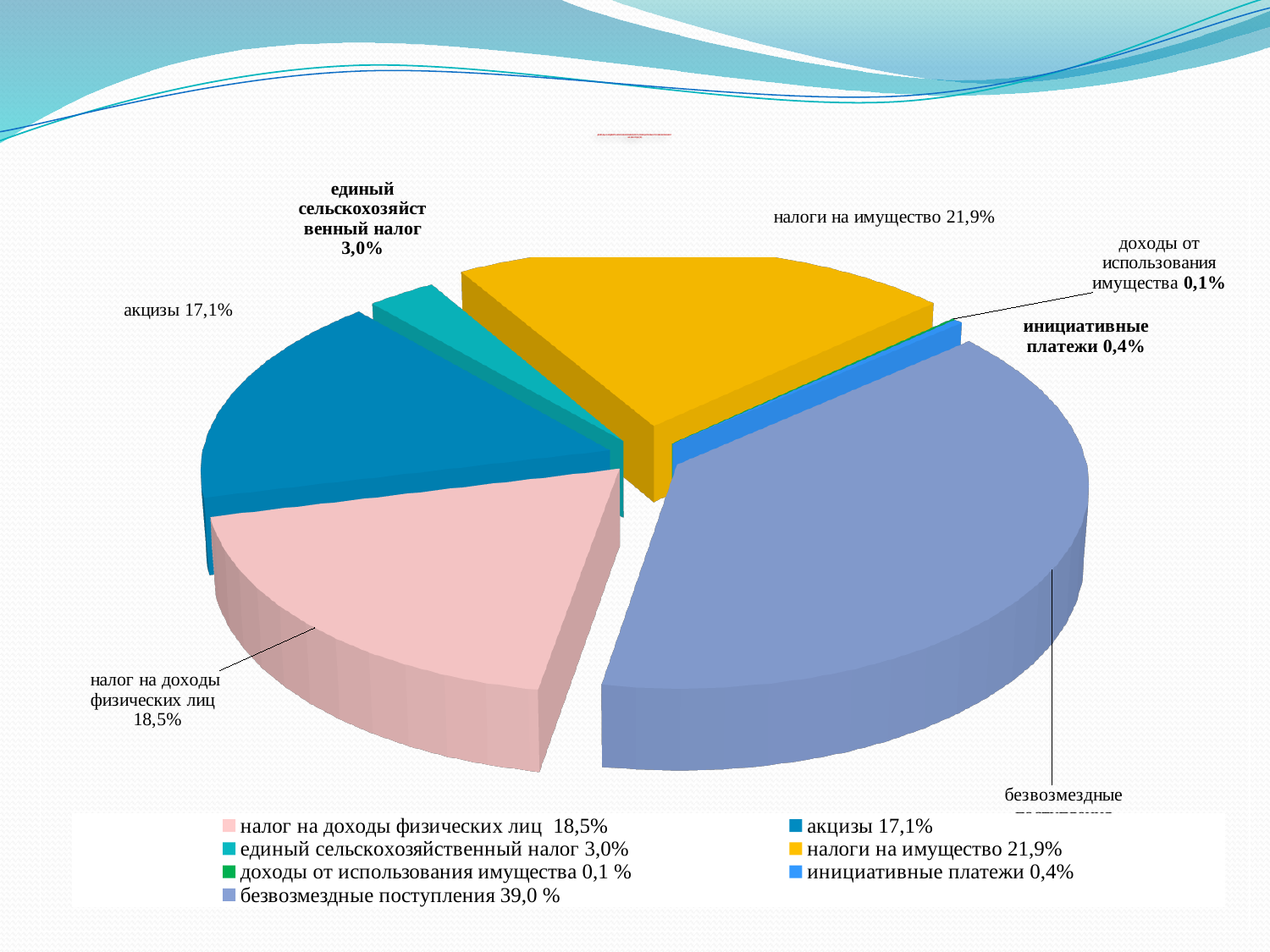
Which category has the largest share of the pie? безвозмездные поступления What is the difference in percentage points between "налоги на имущество" and "налог на доходы физических лиц"? 3,4 How many categories does the pie chart have? 7 What is the value shown for "доходы от использования имущества"? 0,1 % What colour is the slice for "налоги на имущество"? yellow What is the value shown for "налоги на имущество"? 21,9% What is the value shown for "акцизы"? 17,1% What share does "безвозмездные поступления" have in the pie chart? 39,0 % What is the value shown for "единый сельскохозяйственный налог"? 3,0% Which is larger: "налог на доходы физических лиц" or "акцизы"? налог на доходы физических лиц What kind of chart is shown on the slide? pie chart Which category has the smallest share of the pie? доходы от использования имущества